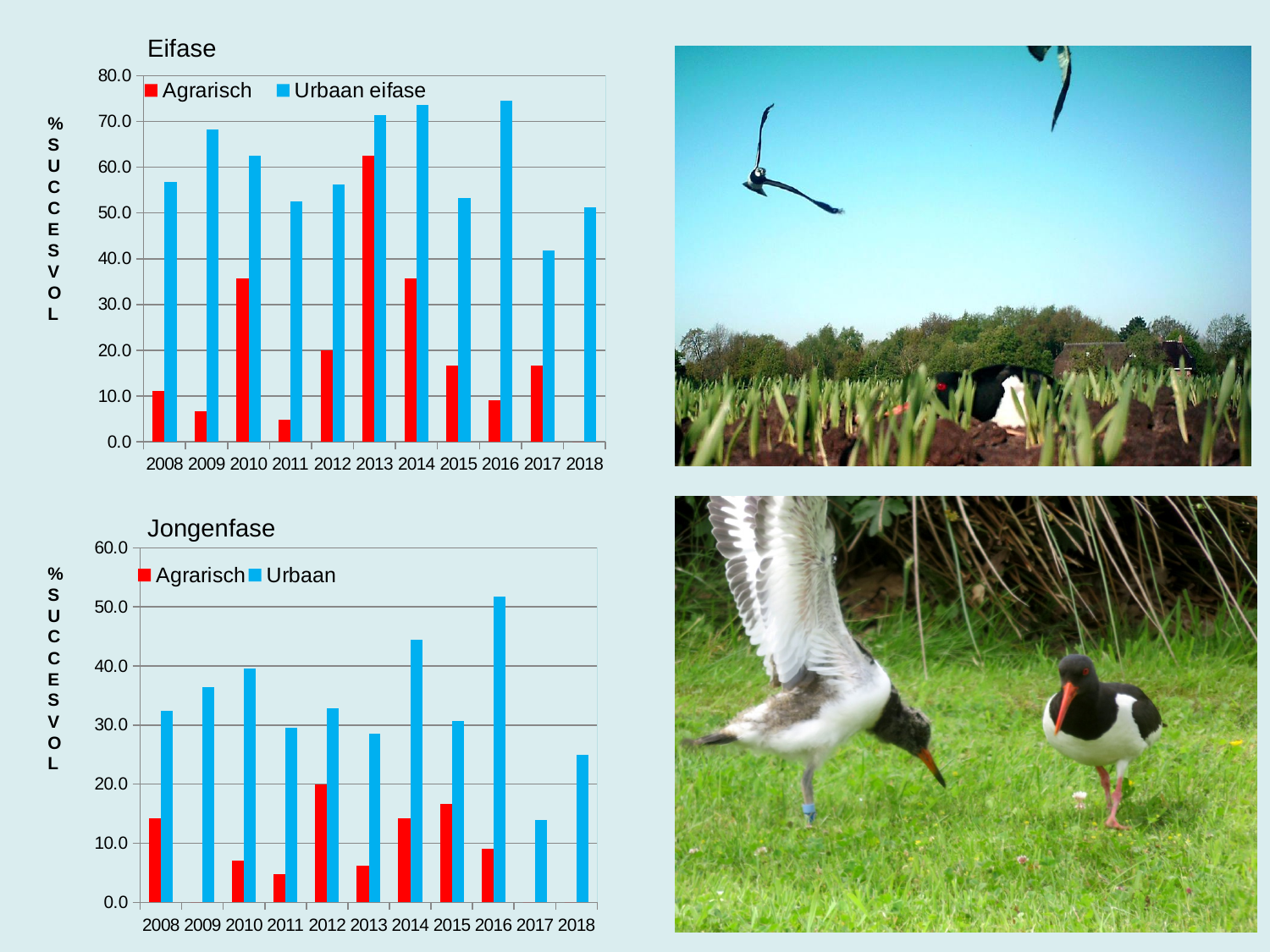
In the Eifase chart, which is larger in 2013: the Agrarisch value or the Urbaan eifase value? Urbaan eifase In the Jongenfase chart, which year has the highest Agrarisch value? 2012 In the Eifase chart, which year has the lowest Urbaan eifase value? 2017 In the Jongenfase chart, is the Urbaan value for 2014 greater or less than 40.0? greater In the Eifase chart, is the Agrarisch value for 2012 greater or less than 30.0? less In the Eifase chart, is the Urbaan eifase value for 2009 greater or less than 60.0? greater In the Eifase chart, which year has the highest Agrarisch value? 2013 In the Jongenfase chart, which year has the highest Urbaan value? 2016 In the Jongenfase chart, which year has the lowest Urbaan value? 2017 How many years are shown on the x axis of the Eifase chart? 11 How many series does the legend of the Eifase chart list? 2 What kind of chart is the Jongenfase chart? bar chart